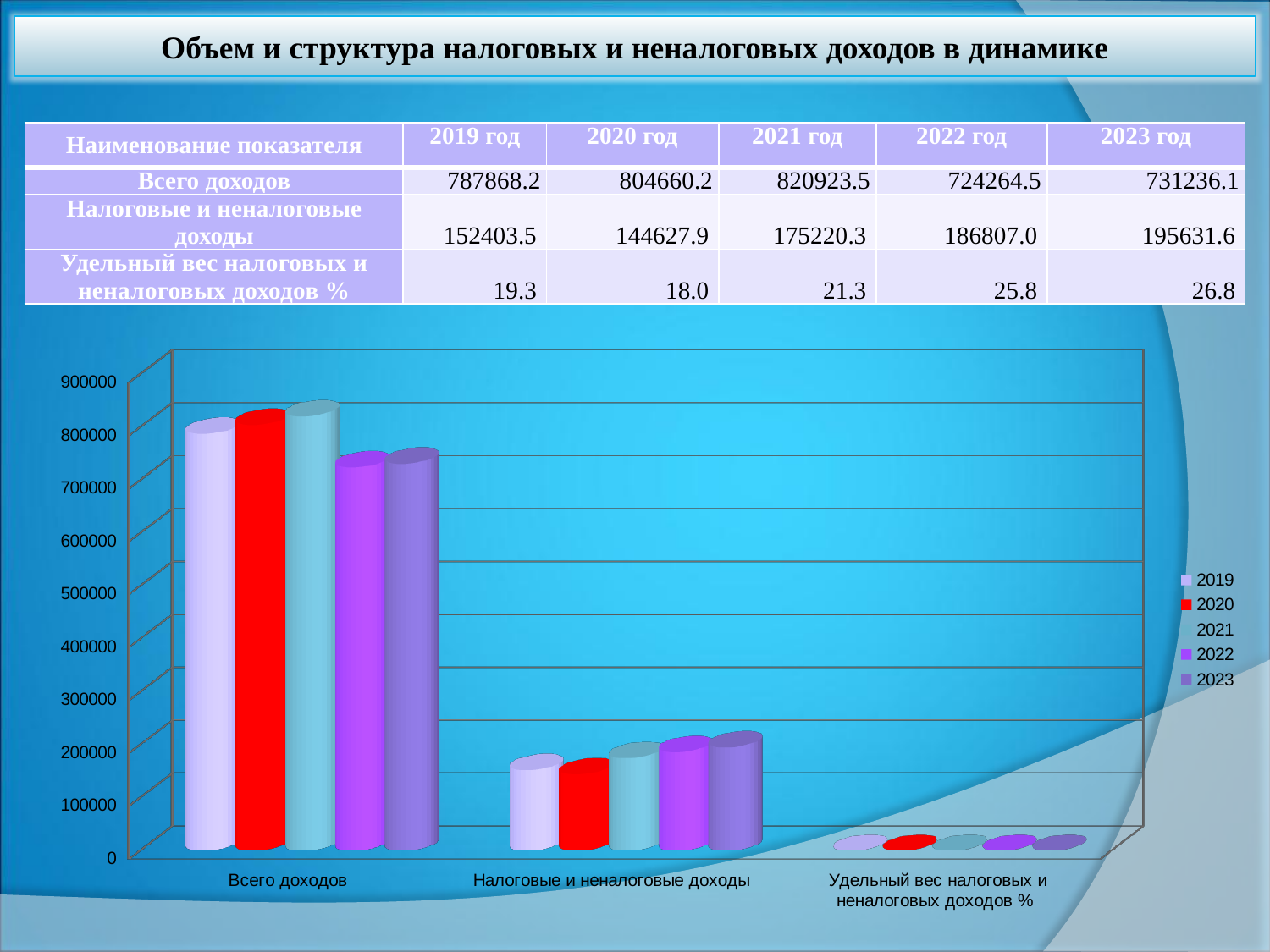
What kind of chart is shown on the slide? bar chart Which colour represents the 2020 series in the chart legend? red What is the value of Удельный вес налоговых и неналоговых доходов % for 2022? 25.8 Which year has the lowest value for Налоговые и неналоговые доходы? 2020 Which year has the highest value for Всего доходов? 2021 How many categories are shown along the x axis of the chart? 3 Is the value for Всего доходов in 2019 greater or less than 700000? greater What is the value of Всего доходов for 2023? 731236.1 How many series does the chart legend list? 5 Is the value for Налоговые и неналоговые доходы in 2023 greater or less than 300000? less Which is larger for Всего доходов: the 2021 value or the 2022 value? 2021 What is the difference between the 2023 and 2019 values for Налоговые и неналоговые доходы? 43228.1